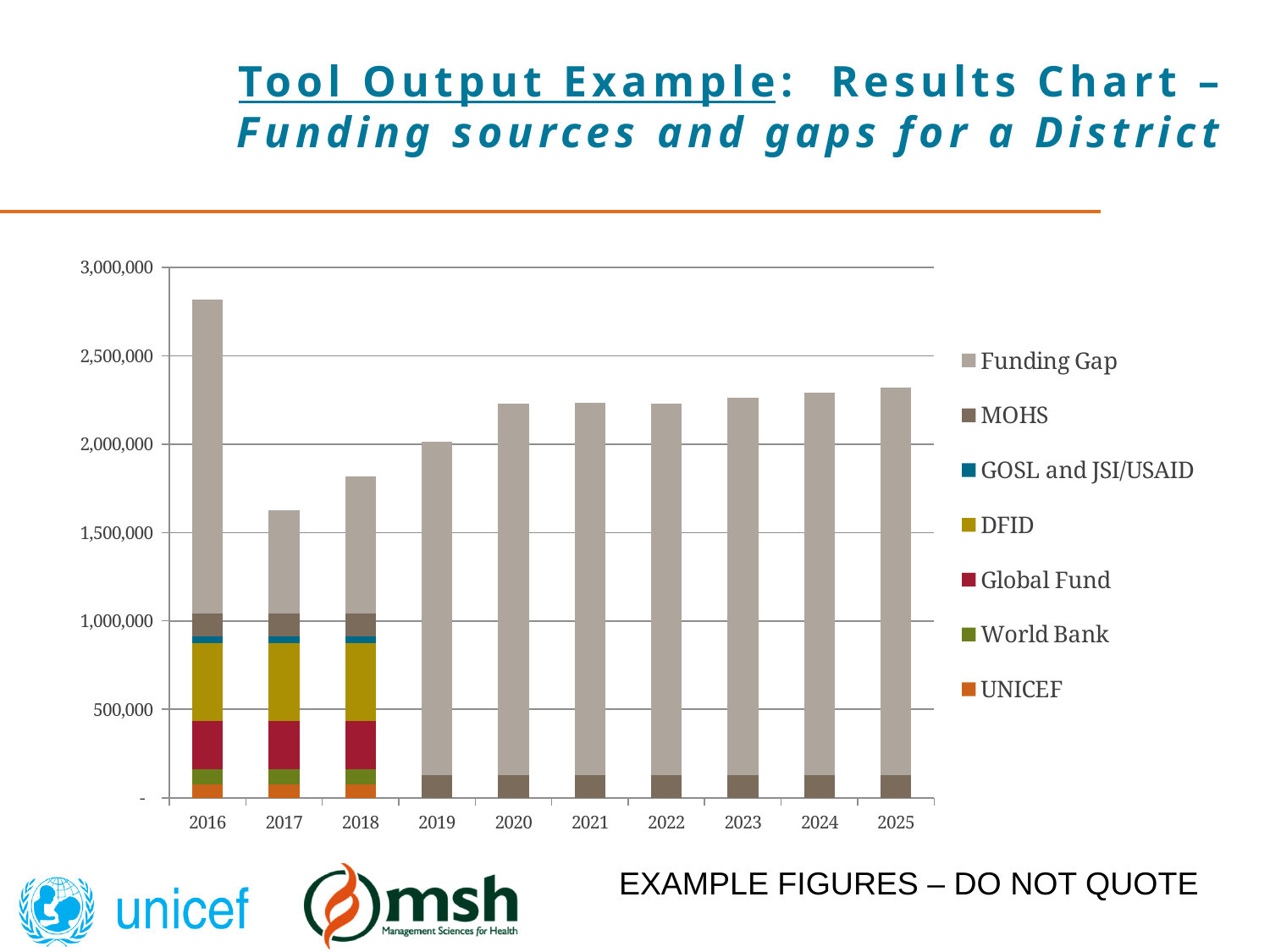
Which year has a taller stacked bar, 2016 or 2017? 2016 Is the total bar height for 2016 greater or less than 2,500,000? greater Which year has the shortest stacked bar in the chart? 2017 Is the total bar height for 2020 greater or less than 2,000,000? greater How many years are shown along the x axis of the chart? 10 How many series does the chart's legend list? 7 From 2019 to 2025, do the total bar heights generally rise or fall? Rise What kind of chart is shown on the slide? Stacked bar chart Is the total bar height for 2017 greater or less than 2,000,000? less Which year has the tallest stacked bar in the chart? 2016 Which series is listed first in the chart's legend? Funding Gap